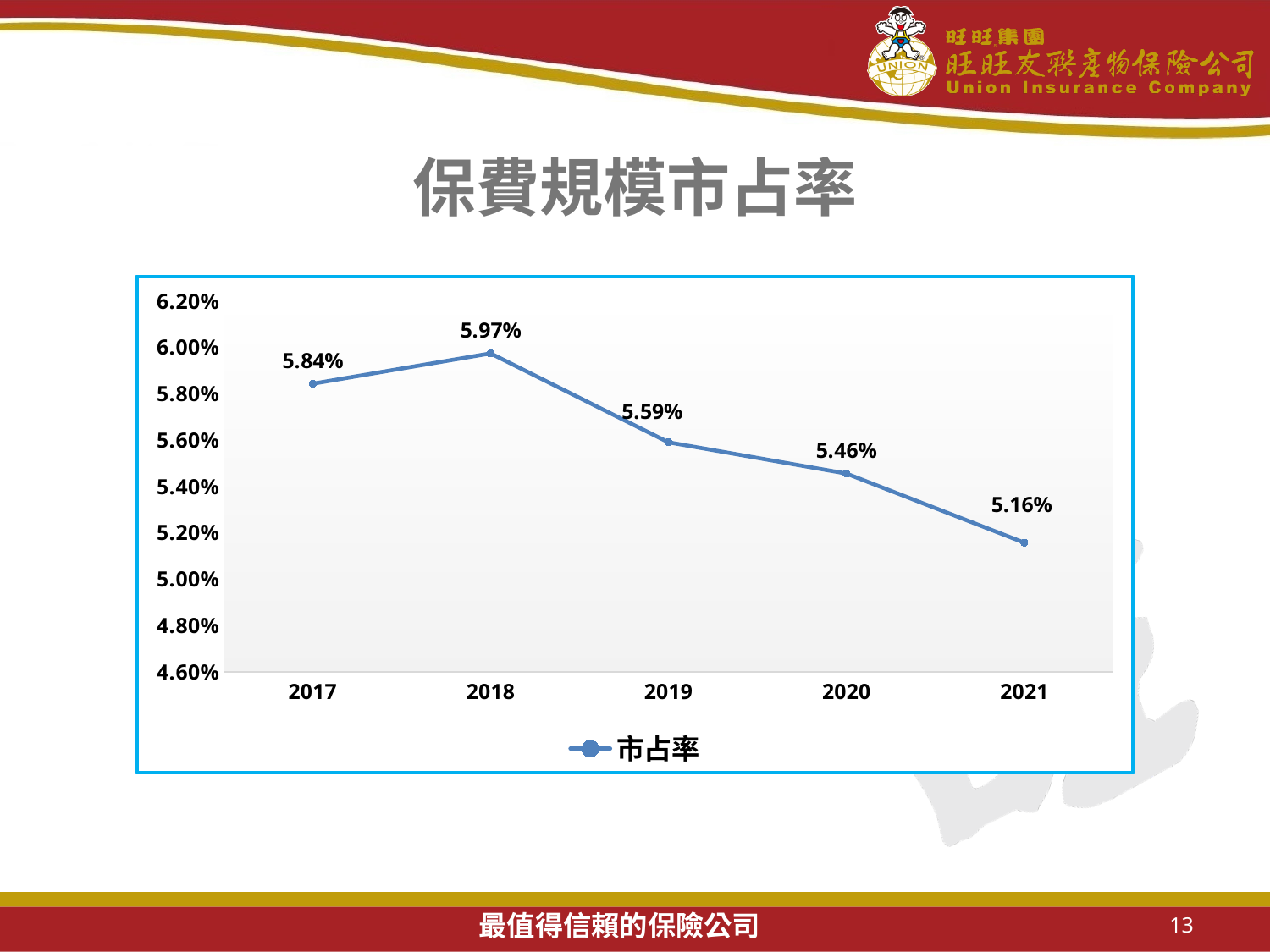
Is the market share for 2020 greater or less than 5.60%? less Which year has a larger market share, 2017 or 2020? 2017 How many years are plotted on the chart? 5 What is the market share (市占率) value for 2018? 5.97% From 2018 to 2021, does the market share rise or fall? fall What kind of chart is shown on the slide? line chart What is the difference between the market share in 2018 and in 2021? 0.81% What is the market share (市占率) value for 2021? 5.16% What is the market share (市占率) value for 2019? 5.59% How many series does the legend list? 1 Which year has the highest market share? 2018 Which year has the lowest market share? 2021